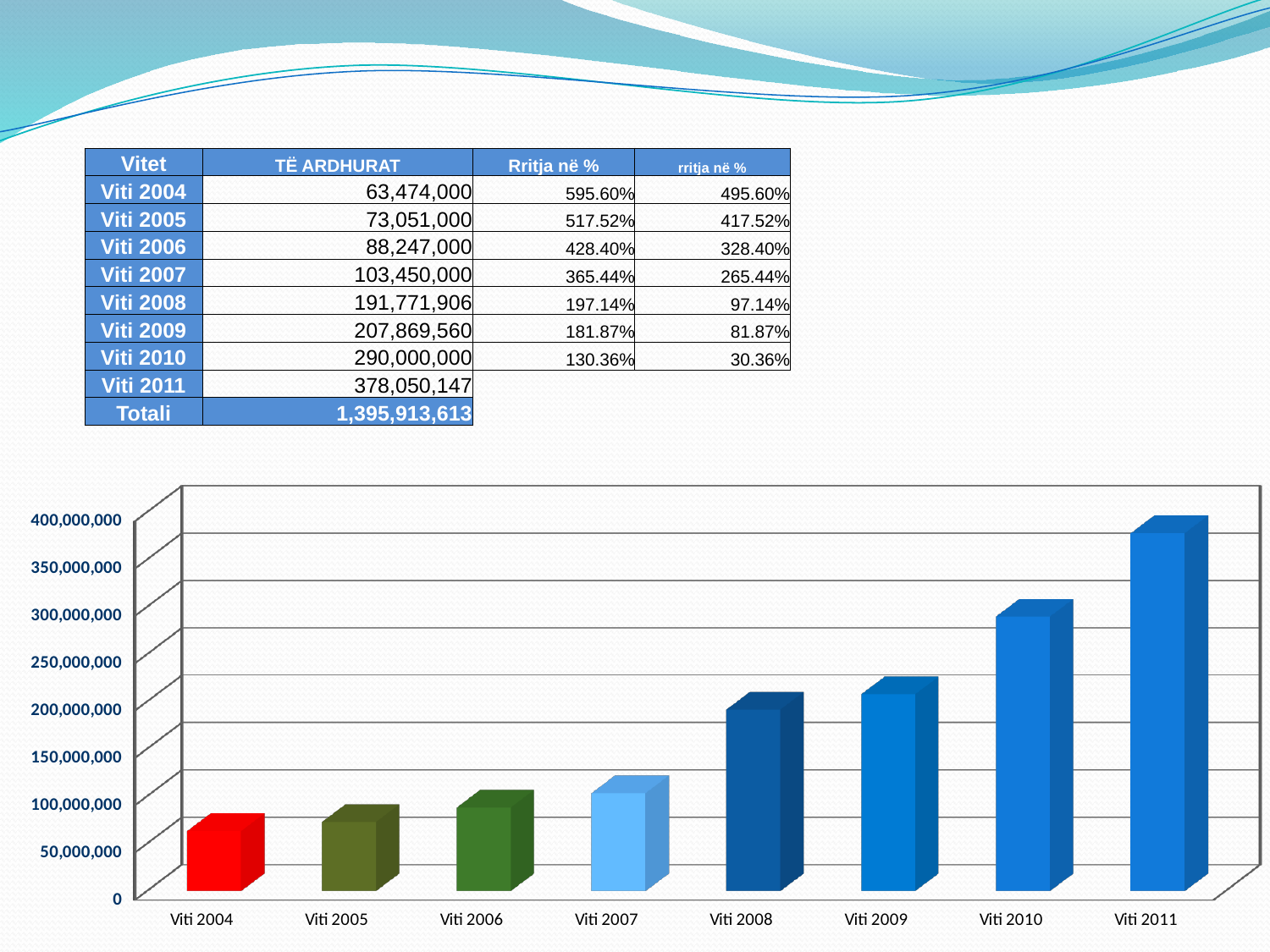
Is the bar for Viti 2008 greater or less than 150,000,000? greater What kind of chart is shown on the slide? bar chart Is the bar for Viti 2011 greater or less than 350,000,000? greater Do the bar values rise or fall from Viti 2004 to Viti 2011? rise How many years (categories) are plotted on the chart? 8 Is the bar for Viti 2010 greater or less than 250,000,000? greater Which year has the tallest bar in the chart? Viti 2011 Which bar is taller, Viti 2010 or Viti 2008? Viti 2010 Which year has the shortest bar in the chart? Viti 2004 What colour is the bar for Viti 2004? red